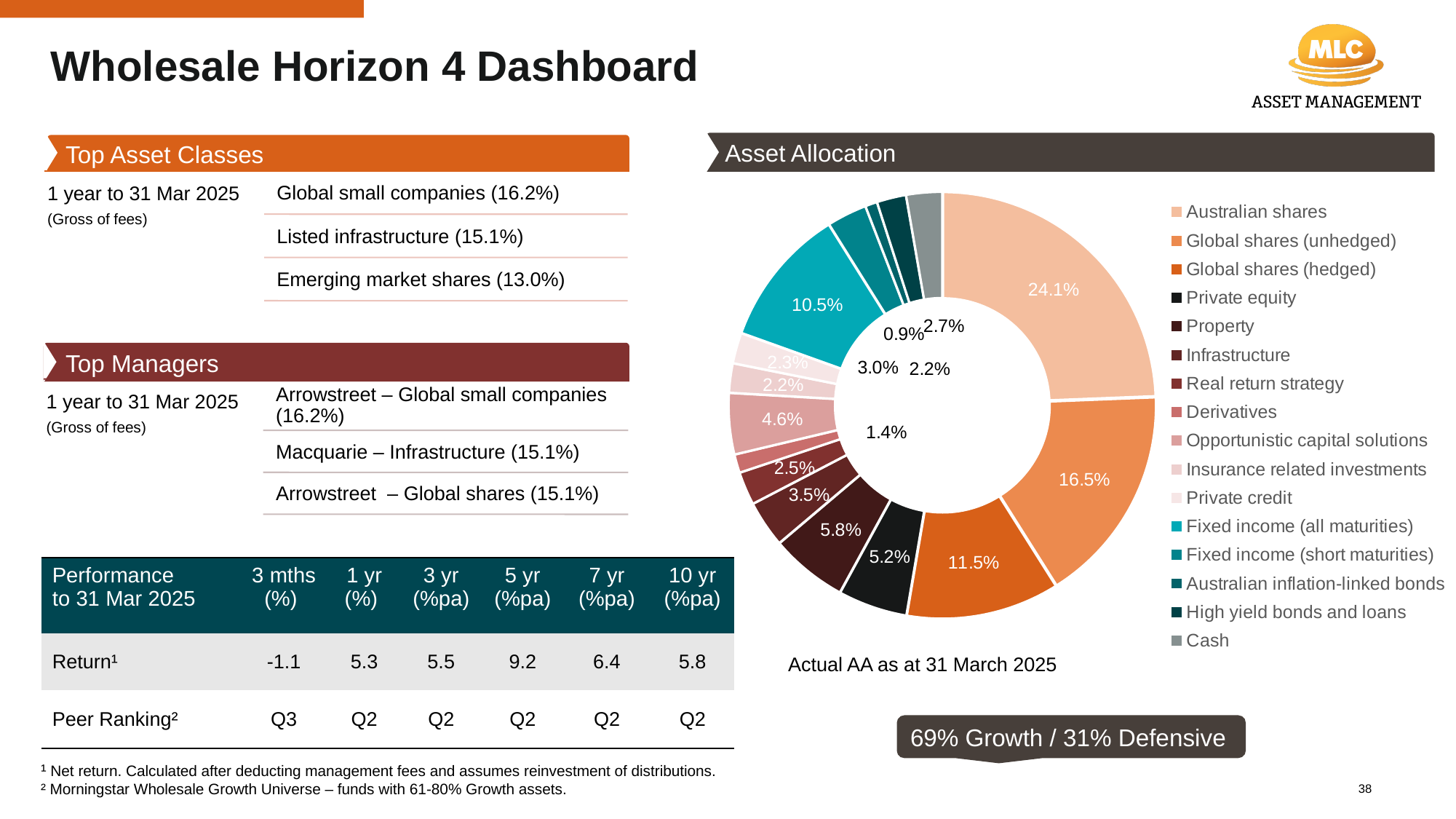
In the Asset Allocation chart, what is the allocation to Fixed income (all maturities)? 10.5% In the Asset Allocation chart, what is the allocation to Global shares (unhedged)? 16.5% Which asset class has the largest allocation in the Asset Allocation chart? Australian shares In the Asset Allocation chart, which is larger: Property or Private equity? Property What type of chart is used for the Asset Allocation? Doughnut (pie) chart In the Asset Allocation chart, what is the allocation to Private equity? 5.2% How many asset classes are listed in the legend of the Asset Allocation chart? 16 In the Asset Allocation chart, what is the allocation to Global shares (hedged)? 11.5% In the Asset Allocation chart, how much larger is the Australian shares allocation than the Global shares (unhedged) allocation? 7.6% In the Asset Allocation chart, what is the allocation to Property? 5.8% What is the title of the chart on the slide? Asset Allocation In the Asset Allocation chart, what share is allocated to Australian shares? 24.1%